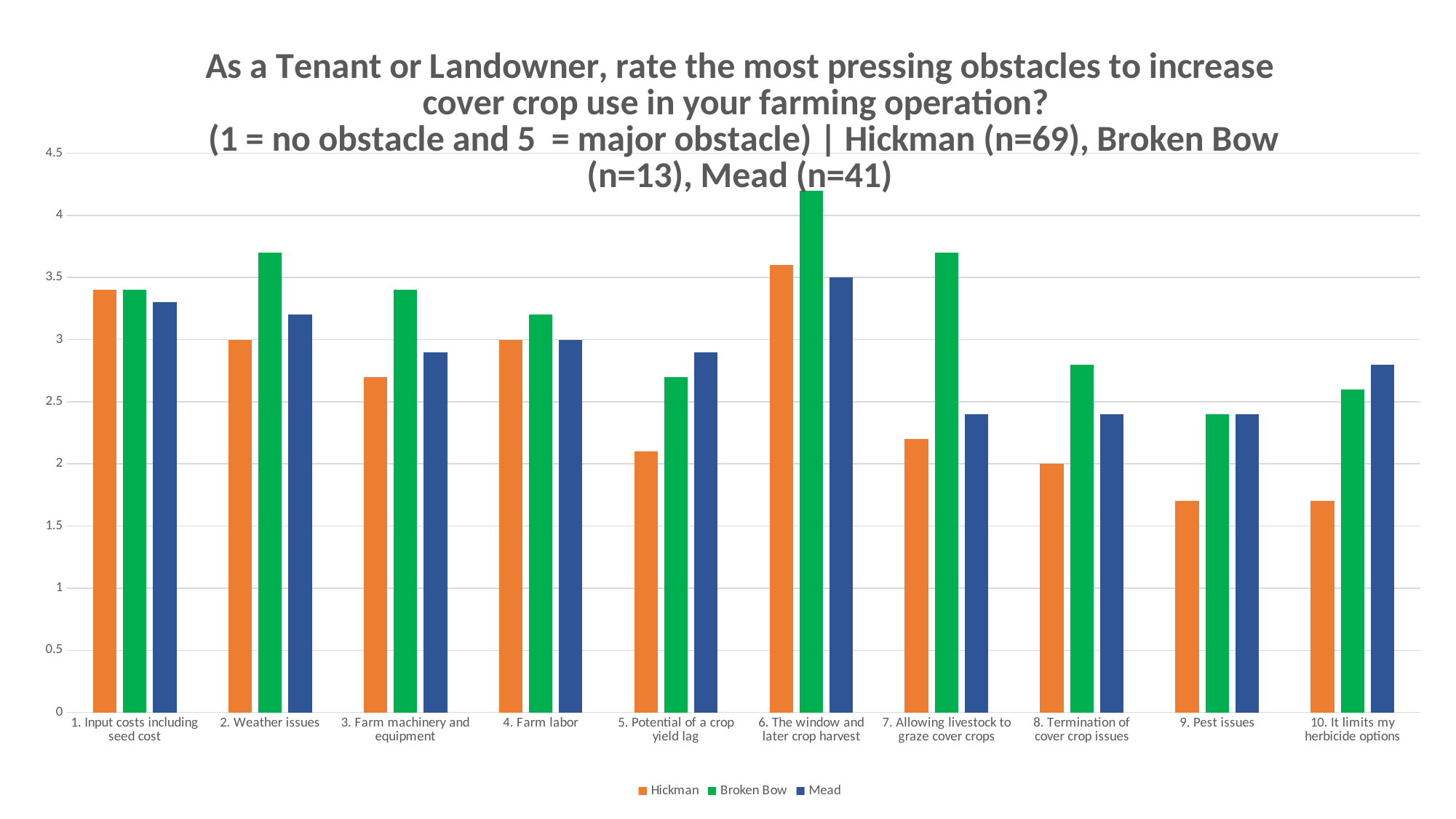
For "10. It limits my herbicide options", which is larger: the Hickman value or the Mead value? Mead Is the Broken Bow value for "2. Weather issues" greater or less than 3.5? greater For "7. Allowing livestock to graze cover crops", which is larger: the Hickman value or the Broken Bow value? Broken Bow For which category is the Broken Bow value lowest? 9. Pest issues What kind of chart is shown on the slide? bar chart Is the Broken Bow value for "6. The window and later crop harvest" greater or less than 4? greater For which category is the Broken Bow value highest? 6. The window and later crop harvest How many series does the legend list? 3 How many obstacle categories are shown along the x axis? 10 Which series is shown in green in the legend? Broken Bow Is the Hickman value for "9. Pest issues" greater or less than 2? less